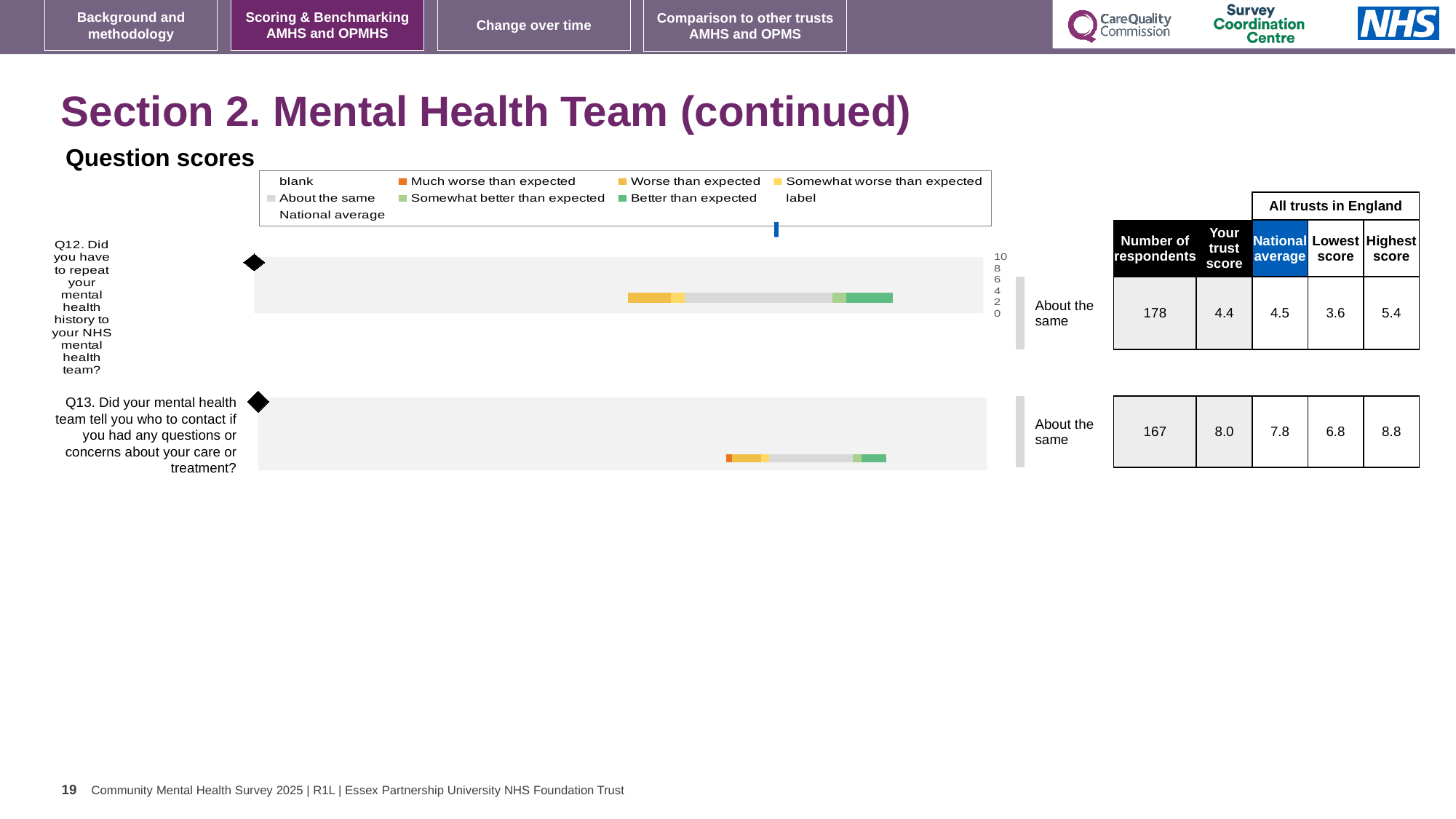
What kind of chart is used to show the question scores for Q12 and Q13? bar chart What benchmark category label is shown next to the Q12 bar? About the same In the table beside the chart, what is the trust score for Q13? 8.0 What benchmark category label is shown next to the Q13 bar? About the same In the table beside the chart, what is the national average for Q12? 4.5 In the table beside the chart, which question has the higher trust score, Q12 or Q13? Q13 Which legend entry is shown in orange? Much worse than expected How many questions (Q12 and Q13) are plotted as bars on the slide? 2 In the table beside the chart, what is the difference between the highest score and the lowest score for Q13? 2.0 In the table beside the chart, how many respondents answered Q13? 167 How many entries does the chart legend list? 9 In the table beside the chart, what is the trust score for Q12? 4.4